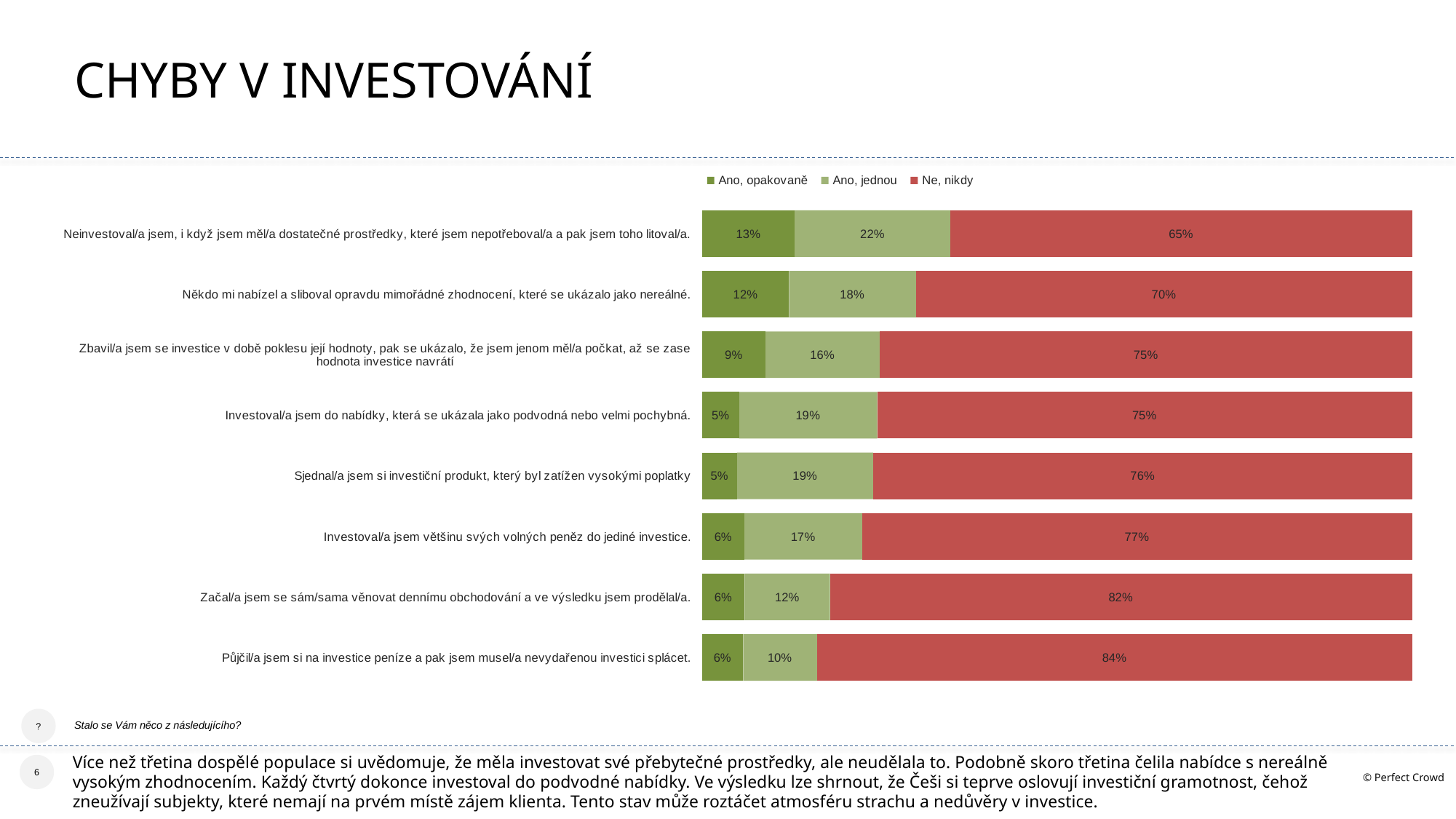
How many categories (statements) are plotted in the chart? 8 What is the 'Ano, jednou' value for 'Investoval/a jsem většinu svých volných peněz do jediné investice.'? 17% What type of chart is shown on the slide? stacked bar chart Which is larger: the 'Ano, jednou' value for 'Zbavil/a jsem se investice v době poklesu její hodnoty...' or for 'Investoval/a jsem do nabídky, která se ukázala jako podvodná nebo velmi pochybná.'? Investoval/a jsem do nabídky, která se ukázala jako podvodná nebo velmi pochybná. What is the total of the stacked bar for 'Sjednal/a jsem si investiční produkt, který byl zatížen vysokými poplatky'? 100% What is the difference between the 'Ne, nikdy' values for 'Začal/a jsem se sám/sama věnovat dennímu obchodování a ve výsledku jsem prodělal/a.' and 'Neinvestoval/a jsem, i když jsem měl/a dostatečné prostředky...'? 17% Which statement has the lowest 'Ano, jednou' value? Půjčil/a jsem si na investice peníze a pak jsem musel/a nevydařenou investici splácet. What is the 'Ano, opakovaně' value for 'Někdo mi nabízel a sliboval opravdu mimořádné zhodnocení, které se ukázalo jako nereálné.'? 12% How many series does the legend list? 3 Which legend entry is shown in red? Ne, nikdy Which statement has the highest 'Ne, nikdy' value? Půjčil/a jsem si na investice peníze a pak jsem musel/a nevydařenou investici splácet. What is the 'Ne, nikdy' value for 'Neinvestoval/a jsem, i když jsem měl/a dostatečné prostředky, které jsem nepotřeboval/a a pak jsem toho litoval/a.'? 65%